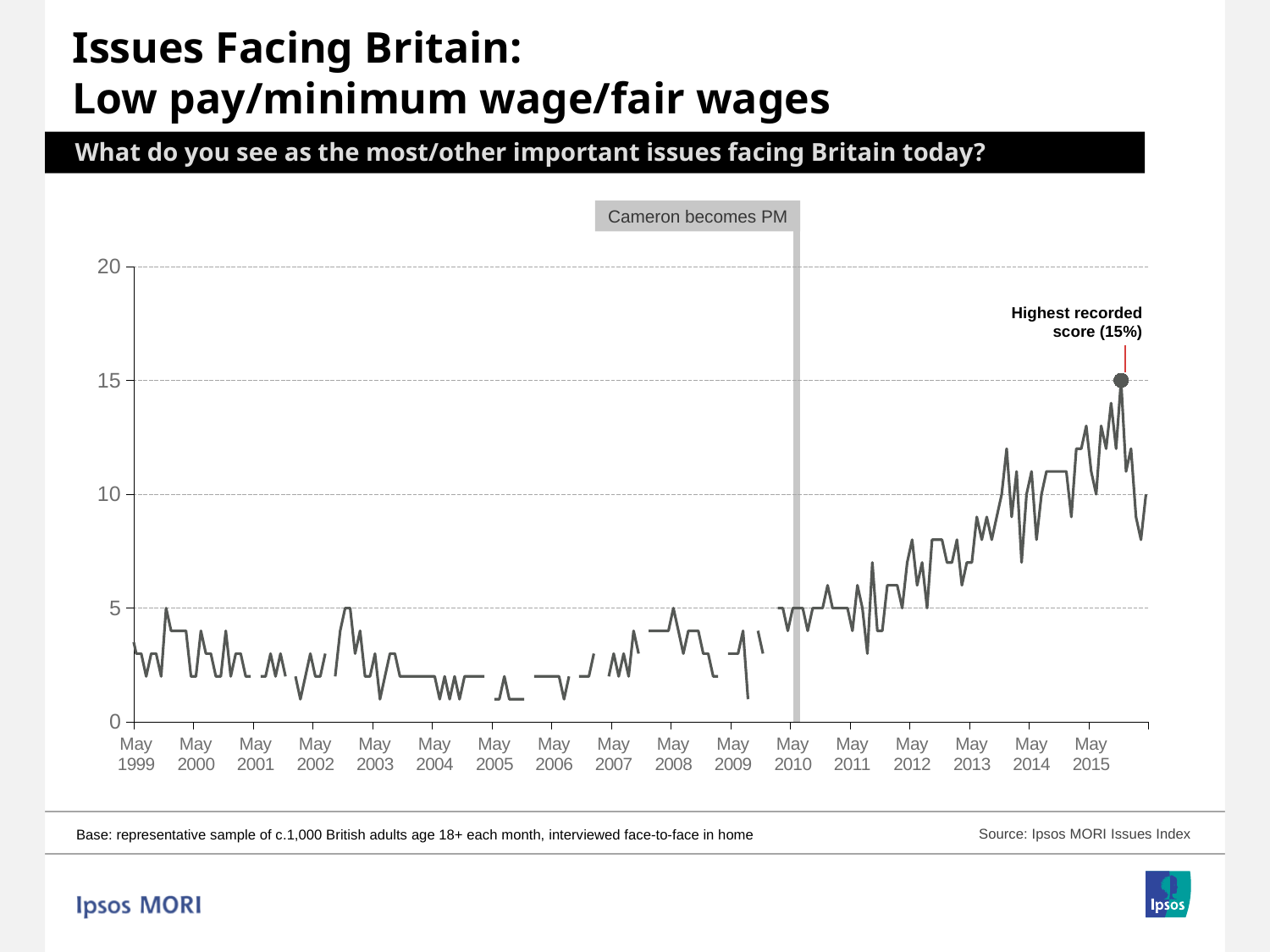
What event does the vertical grey bar on the chart mark? Cameron becomes PM Overall, do the values rise or fall from May 1999 to May 2015? rise What is the highest value shown on the y axis? 20 How many 'May' year labels are shown along the x axis? 17 Is the value for May 1999 greater or less than 5? less What is the highest recorded score shown on the chart? 15% Is the value for May 2005 greater or less than 5? less Is the value for May 2013 greater or less than 5? greater Which is larger, the value for May 2014 or the value for May 2004? May 2014 What kind of chart is shown on the slide? line chart